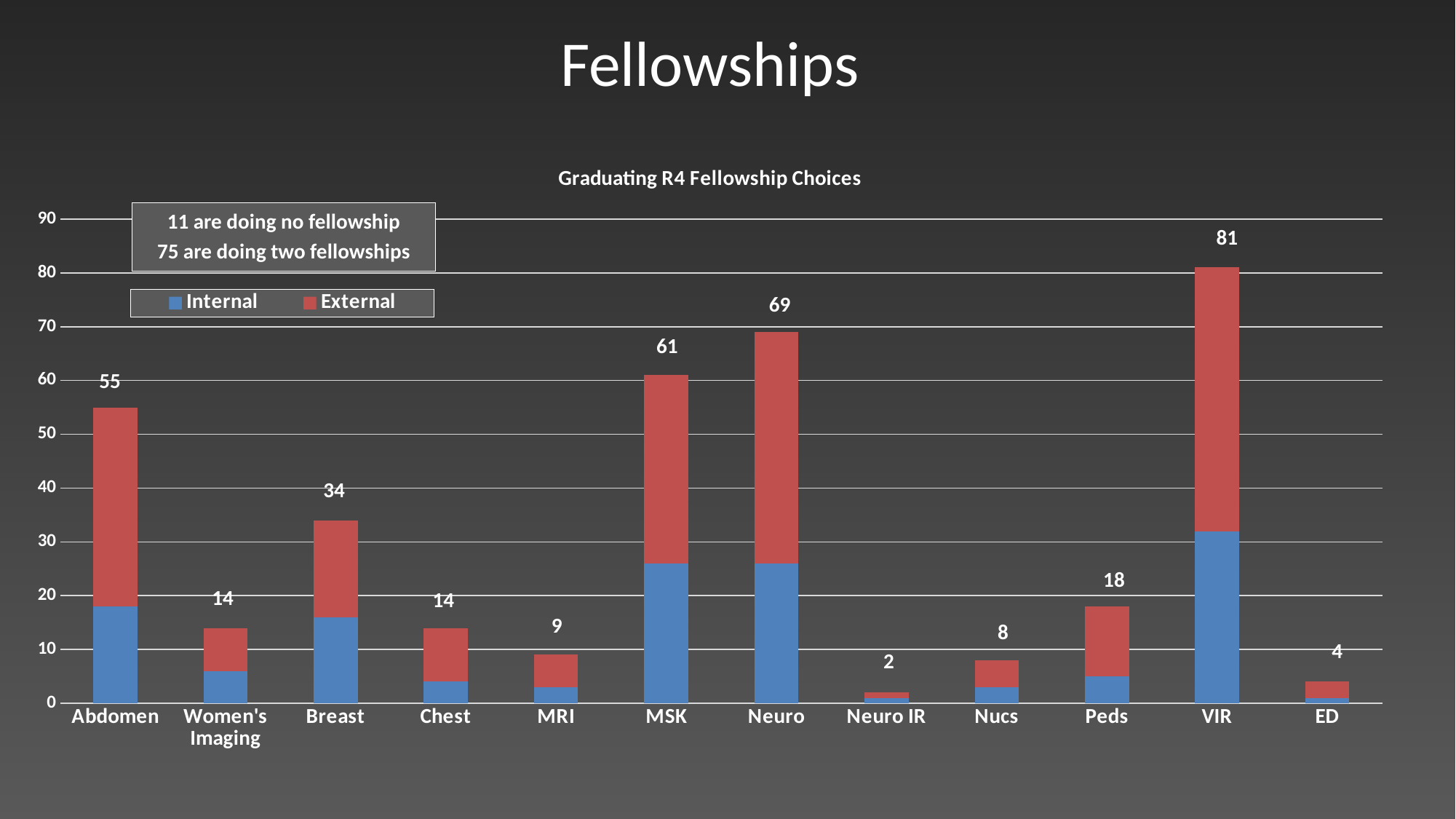
What is the total value shown for the VIR bar? 81 Which category has the lowest total? Neuro IR What is the difference between the totals for Neuro and MSK? 8 What kind of chart is shown? Stacked bar chart Is the Internal value for MSK greater or less than 20? greater Which has a larger total, Abdomen or Breast? Abdomen How many categories are shown on the x axis? 12 What is the title of the chart? Graduating R4 Fellowship Choices What is the total value shown for the Peds bar? 18 Which category has the highest total? VIR How many series does the legend list? 2 What is the total value shown for the Breast bar? 34